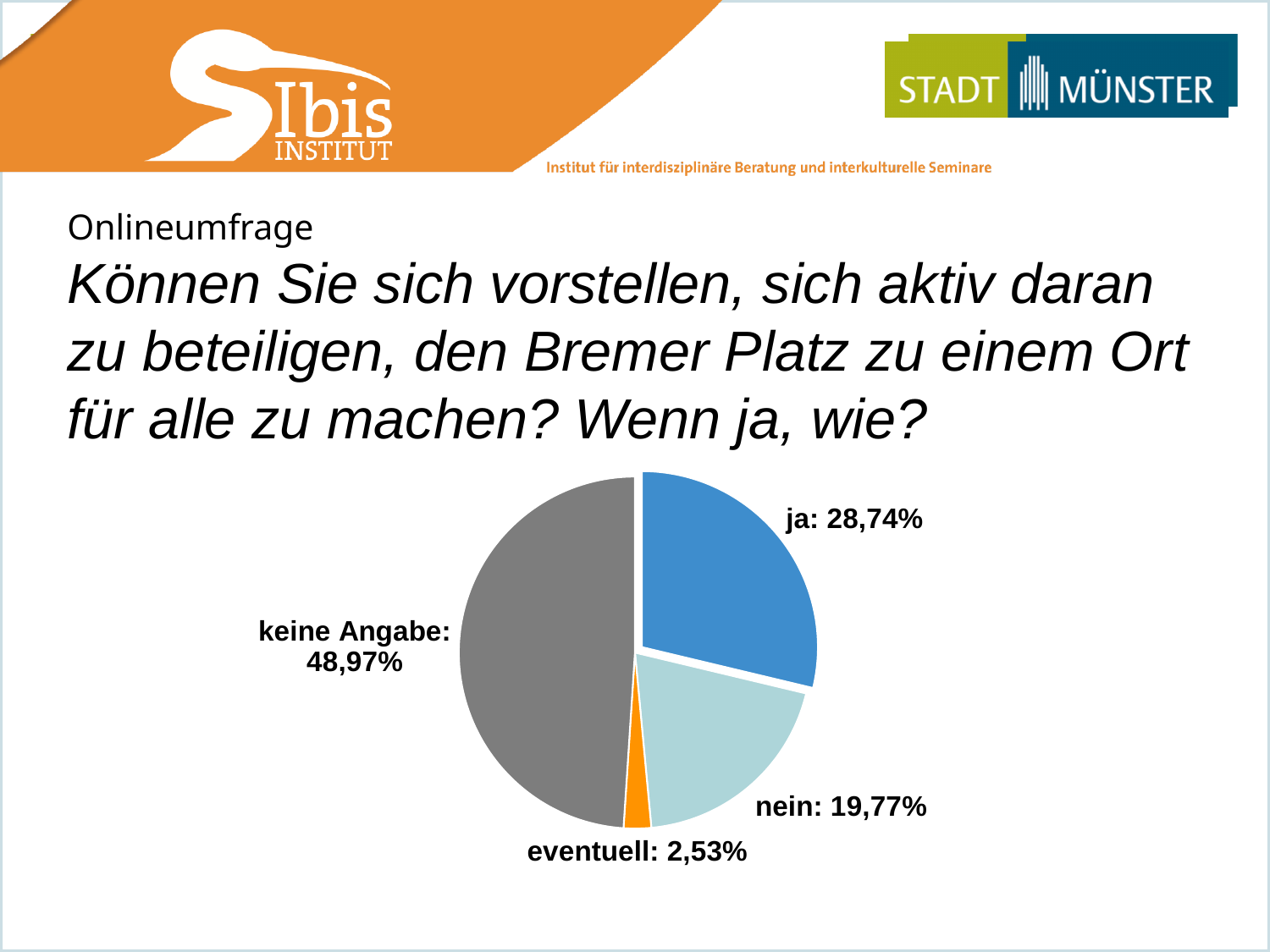
What share of responses is labelled "ja" in the pie chart? 28,74% What share of responses is labelled "eventuell" in the pie chart? 2,53% How many slices does the pie chart have? 4 What kind of chart is shown on the slide? pie chart Which is larger in the pie chart, the share for "ja" or the share for "nein"? ja What share of responses is labelled "nein" in the pie chart? 19,77% What share of responses is labelled "keine Angabe" in the pie chart? 48,97% Which category has the largest slice in the pie chart? keine Angabe What is the difference in percentage points between the "ja" slice and the "nein" slice? 8,97 What is the difference in percentage points between the "keine Angabe" slice and the "ja" slice? 20,23 What colour is the "eventuell" slice in the pie chart? orange Which category has the smallest slice in the pie chart? eventuell